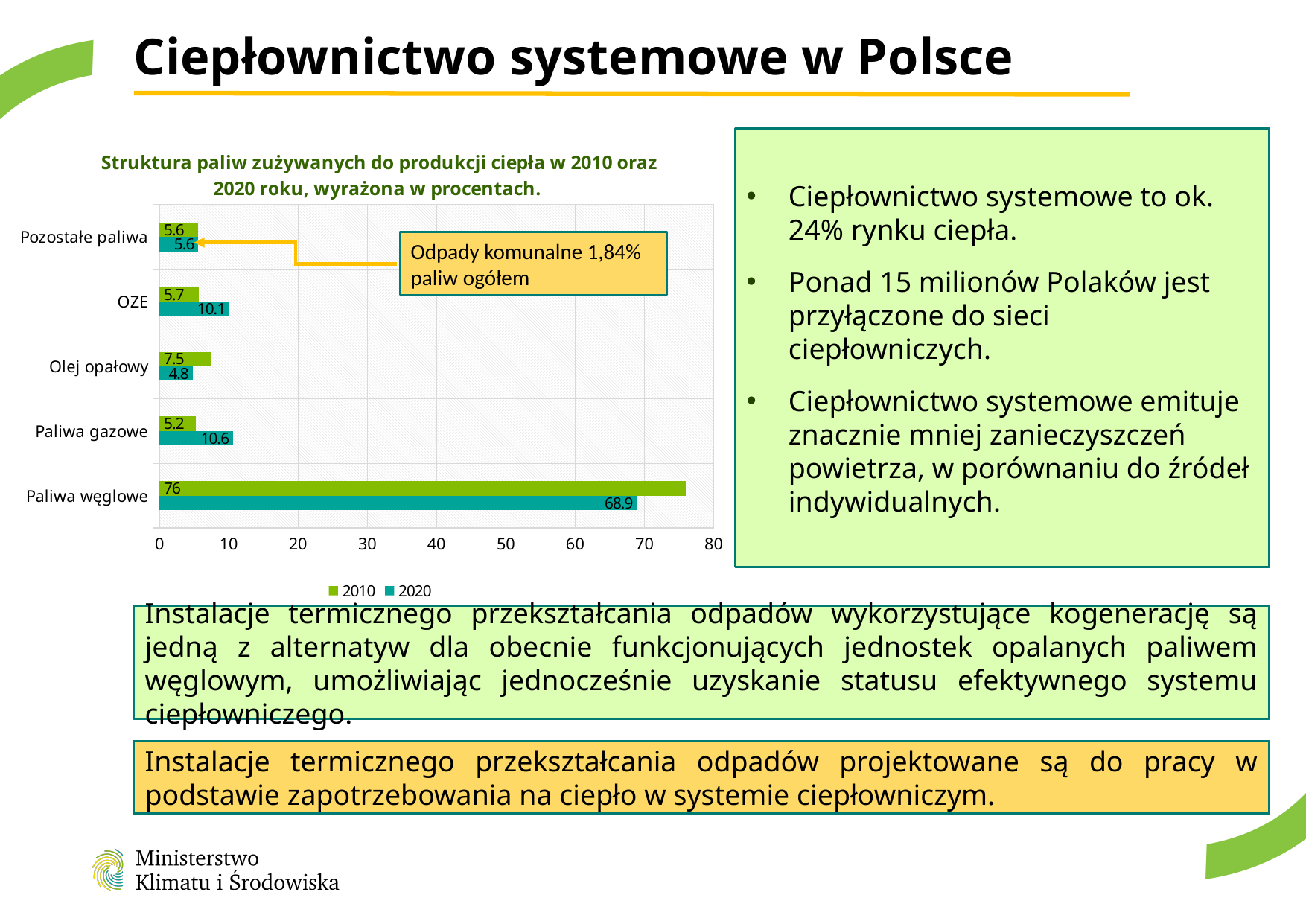
What is the difference between the 2010 and 2020 values for Paliwa węglowe? 7.1 Which category has the lowest 2020 value? Olej opałowy What is the 2010 value for Paliwa węglowe? 76 What is the 2020 value for Paliwa gazowe? 10.6 What is the 2010 value for Olej opałowy? 7.5 What is the 2020 value for OZE? 10.1 How many categories are shown on the chart? 5 Which is larger for Paliwa gazowe, the 2010 value or the 2020 value? 2020 Which category has the highest 2020 value? Paliwa węglowe What kind of chart is shown on the slide? Bar chart What is the 2020 value for Paliwa węglowe? 68.9 How many series does the legend list? 2